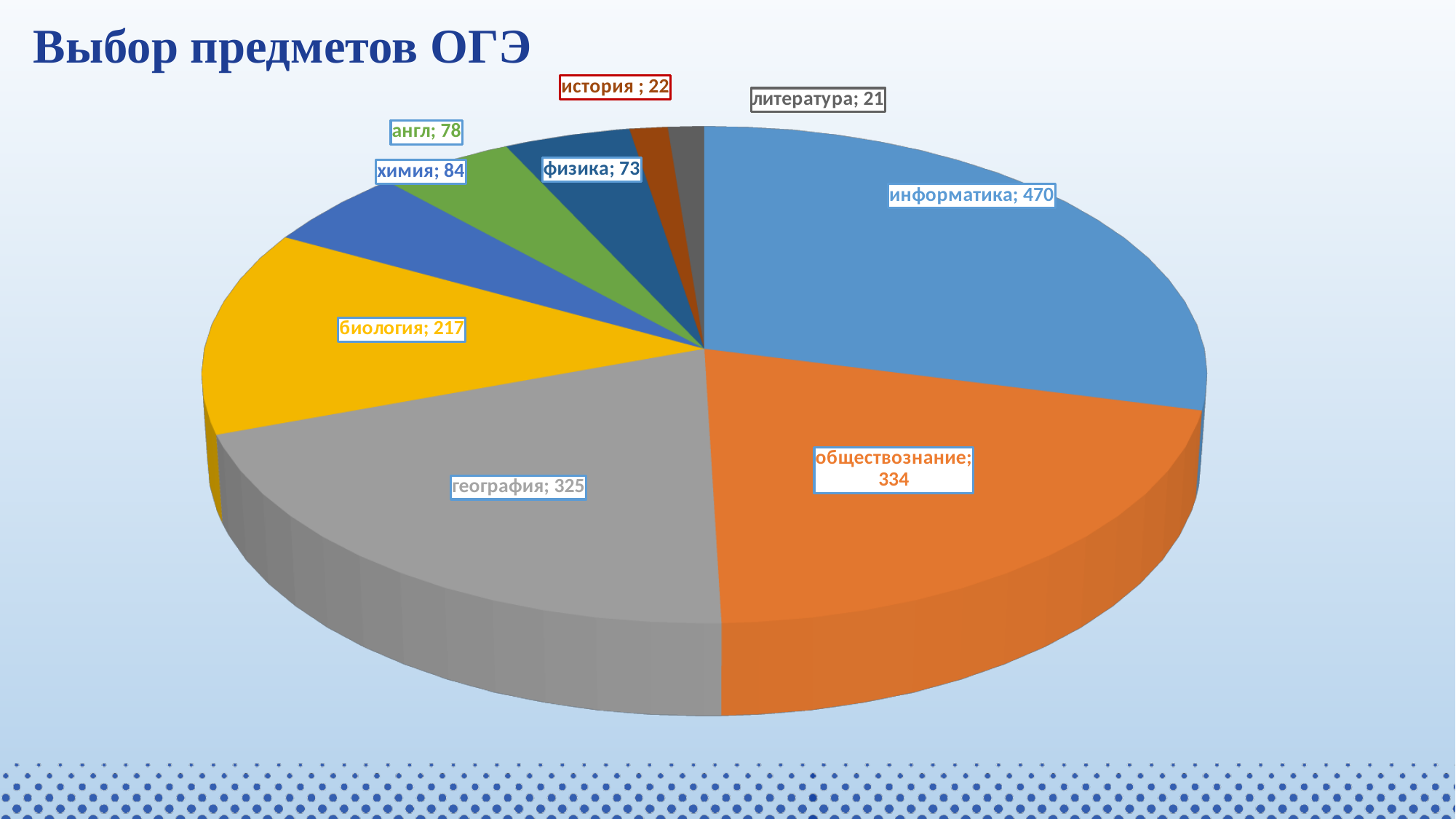
What is the value for информатика? 470 Which is larger, the value for обществознание or the value for география? обществознание What is the value for география? 325 How many subjects are shown in the pie chart? 9 What kind of chart is shown on the slide? pie chart Which is larger, the value for физика or the value for англ? англ What is the value for химия? 84 Which subject has the highest value? информатика What is the title of the chart? Выбор предметов ОГЭ What is the difference between the values for информатика and обществознание? 136 Which subject has the lowest value? литература What is the difference between the values for география and биология? 108